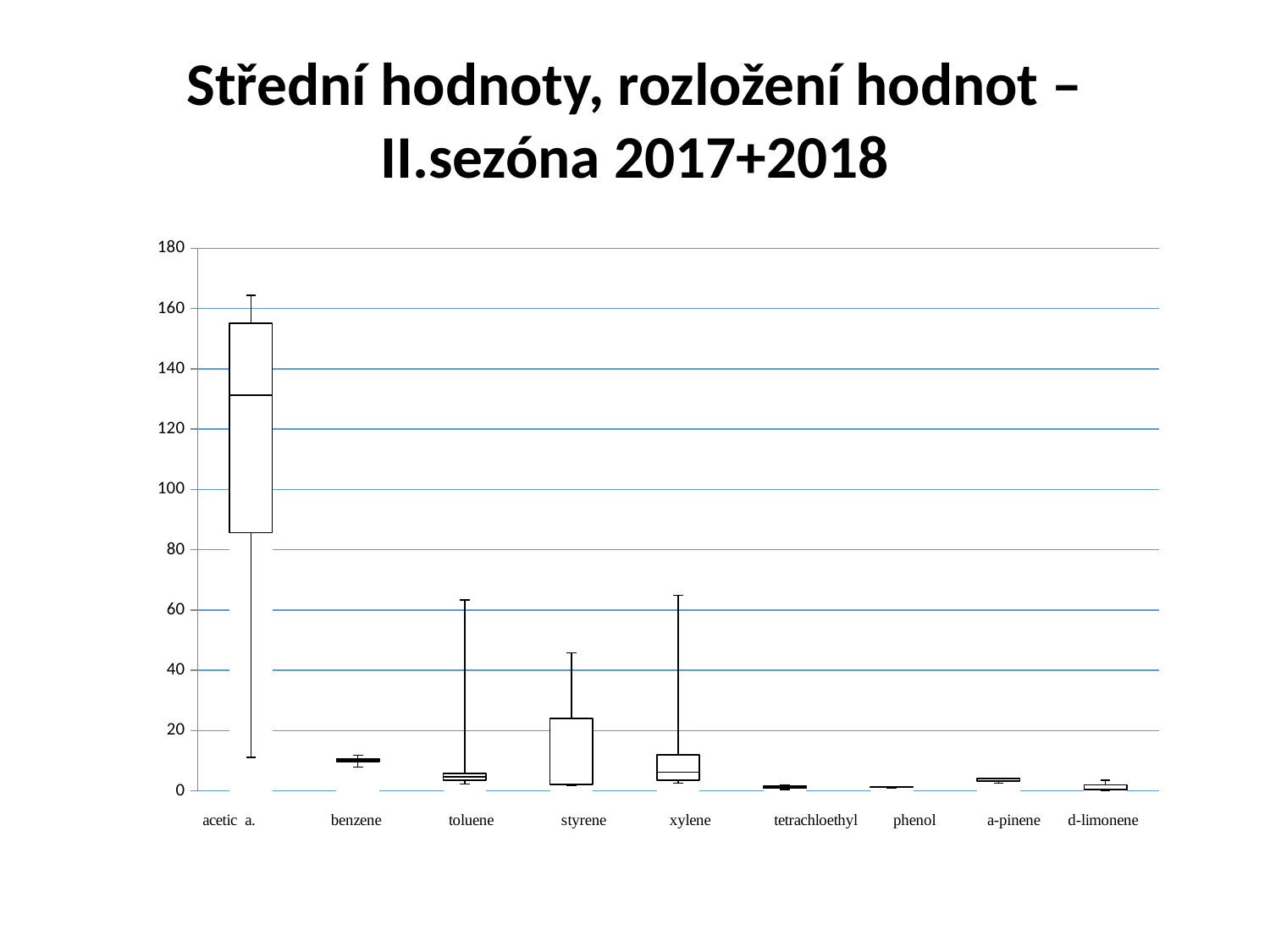
Which category has the highest values on the chart? acetic a. What is the title of the slide? Střední hodnoty, rozložení hodnot – II.sezóna 2017+2018 How many categories are shown along the x axis? 9 Which has a higher box top, styrene or xylene? styrene Which has higher values, acetic a. or benzene? acetic a. Is the top of the upper whisker for acetic a. greater or less than 160? greater Is the top of the upper whisker for styrene greater or less than 60? less What kind of chart is shown on the slide? box-and-whisker (box plot) chart What is the highest value shown on the vertical axis? 180 Is the bottom of the lower whisker for acetic a. greater or less than 20? less